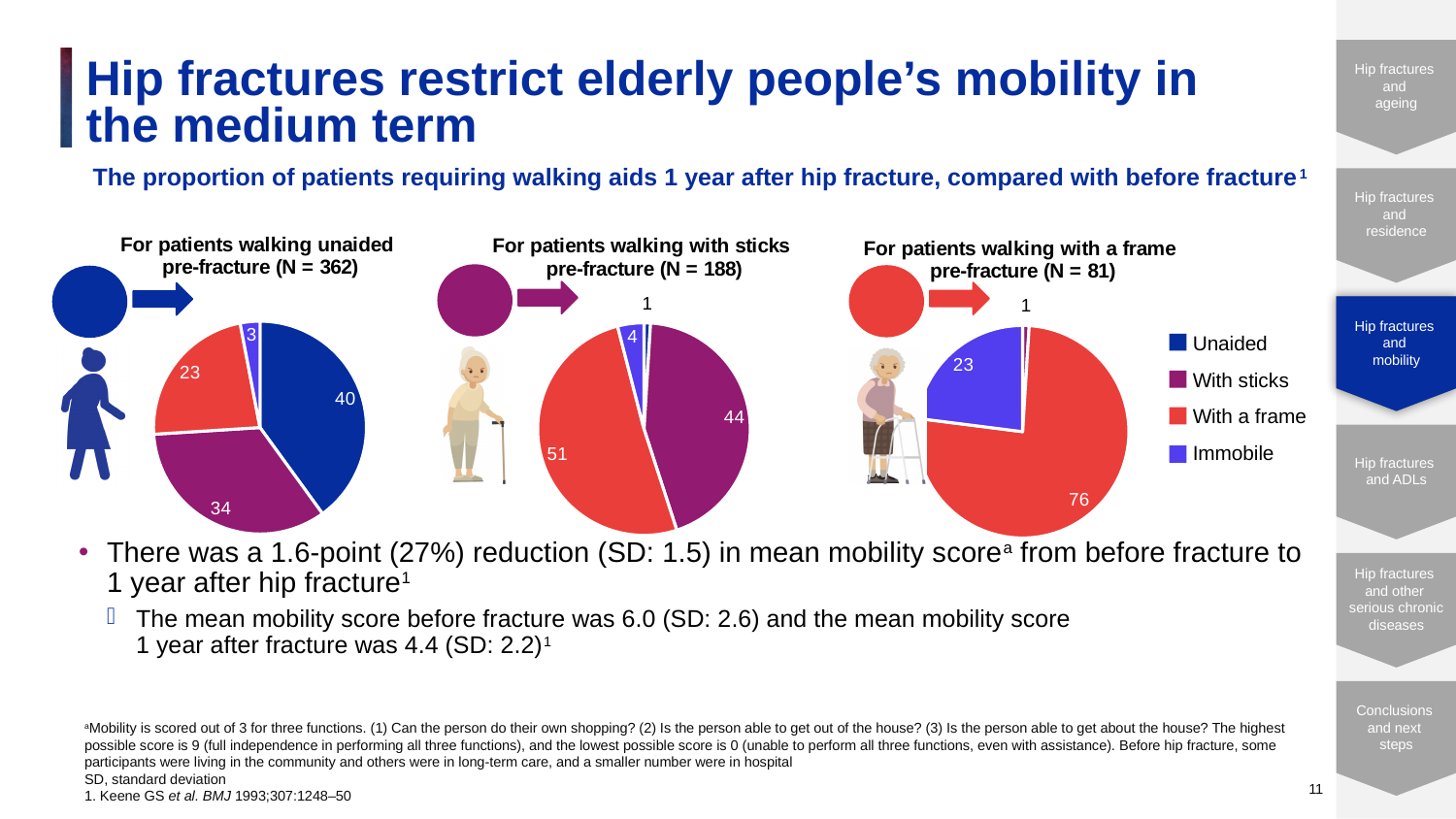
In the pie chart for patients walking with sticks pre-fracture (N = 188), what is the value for 'With sticks'? 44 What type of chart is used to show the proportion of patients requiring walking aids? Pie chart How many pie charts are shown on the slide? 3 In the pie chart for patients walking unaided pre-fracture (N = 362), which category has the smallest slice? Immobile In the pie chart for patients walking unaided pre-fracture (N = 362), which category has the largest slice? Unaided In the pie chart for patients walking with sticks pre-fracture (N = 188), which is larger: 'With a frame' or 'With sticks'? With a frame In the pie chart for patients walking unaided pre-fracture (N = 362), what is the value for 'With a frame'? 23 How many categories does the shared legend list for the pie charts? 4 In the pie chart for patients walking with a frame pre-fracture (N = 81), what is the value for 'Immobile'? 23 In the pie chart for patients walking unaided pre-fracture (N = 362), what is the difference between the 'Unaided' and 'With sticks' values? 6 In the pie chart for patients walking with a frame pre-fracture (N = 81), what is the value for 'With a frame'? 76 In the pie chart for patients walking with sticks pre-fracture (N = 188), which category has the largest slice? With a frame